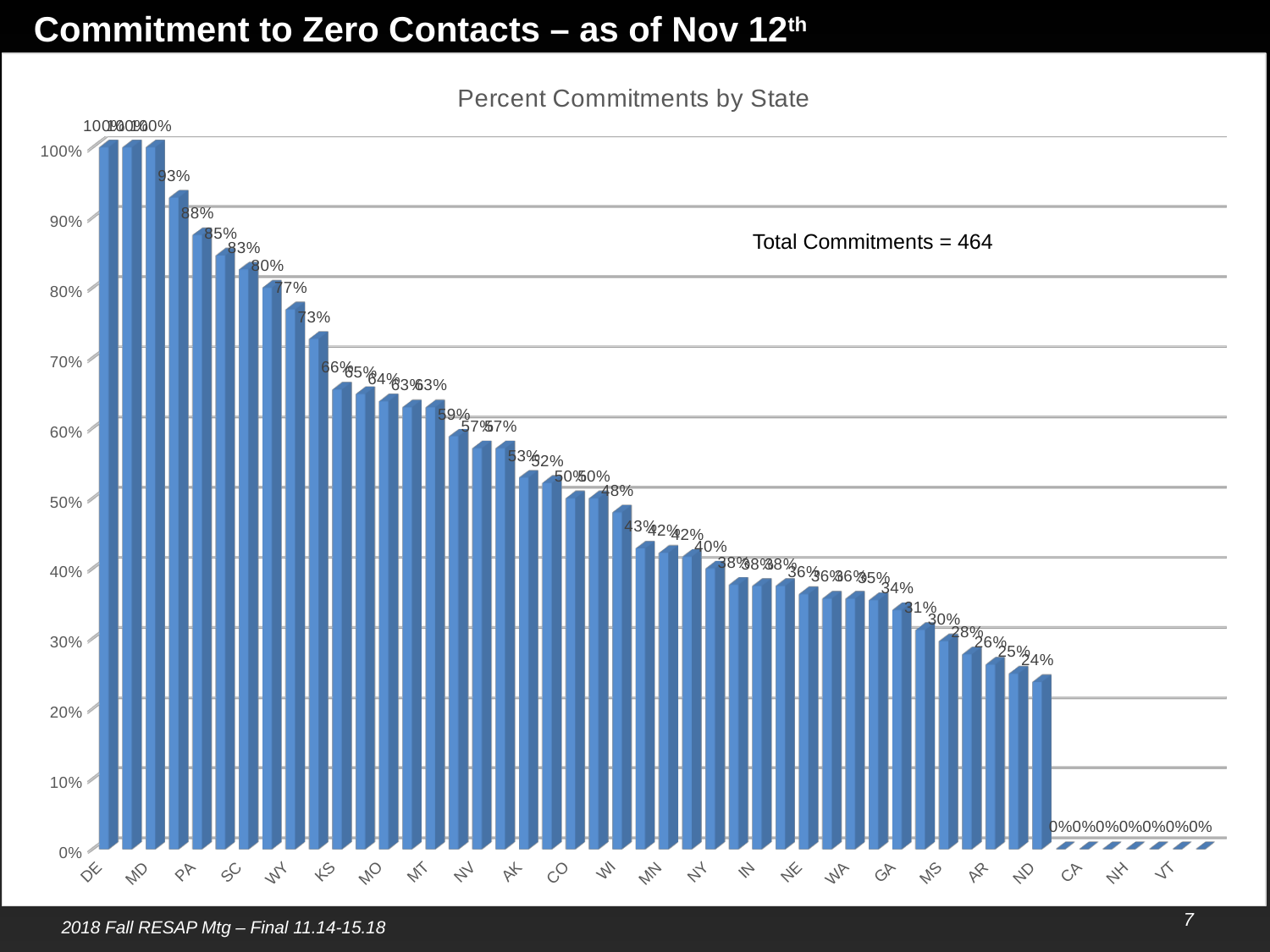
What is the title of the chart? Percent Commitments by State What is the highest value shown on the chart? 100% What is the value for VT? 0% What is the total number of commitments stated on the chart? 464 Which is larger, the value for DE or the value for VT? DE Is the value for ND greater or less than 30%? less What kind of chart is shown on the slide? bar chart How many bars show a value of 0%? 7 What is the value for DE? 100% Do the values rise or fall moving from left to right along the x axis? fall What is the difference between the value for DE and the value for PA? 12% What is the value for PA? 88%